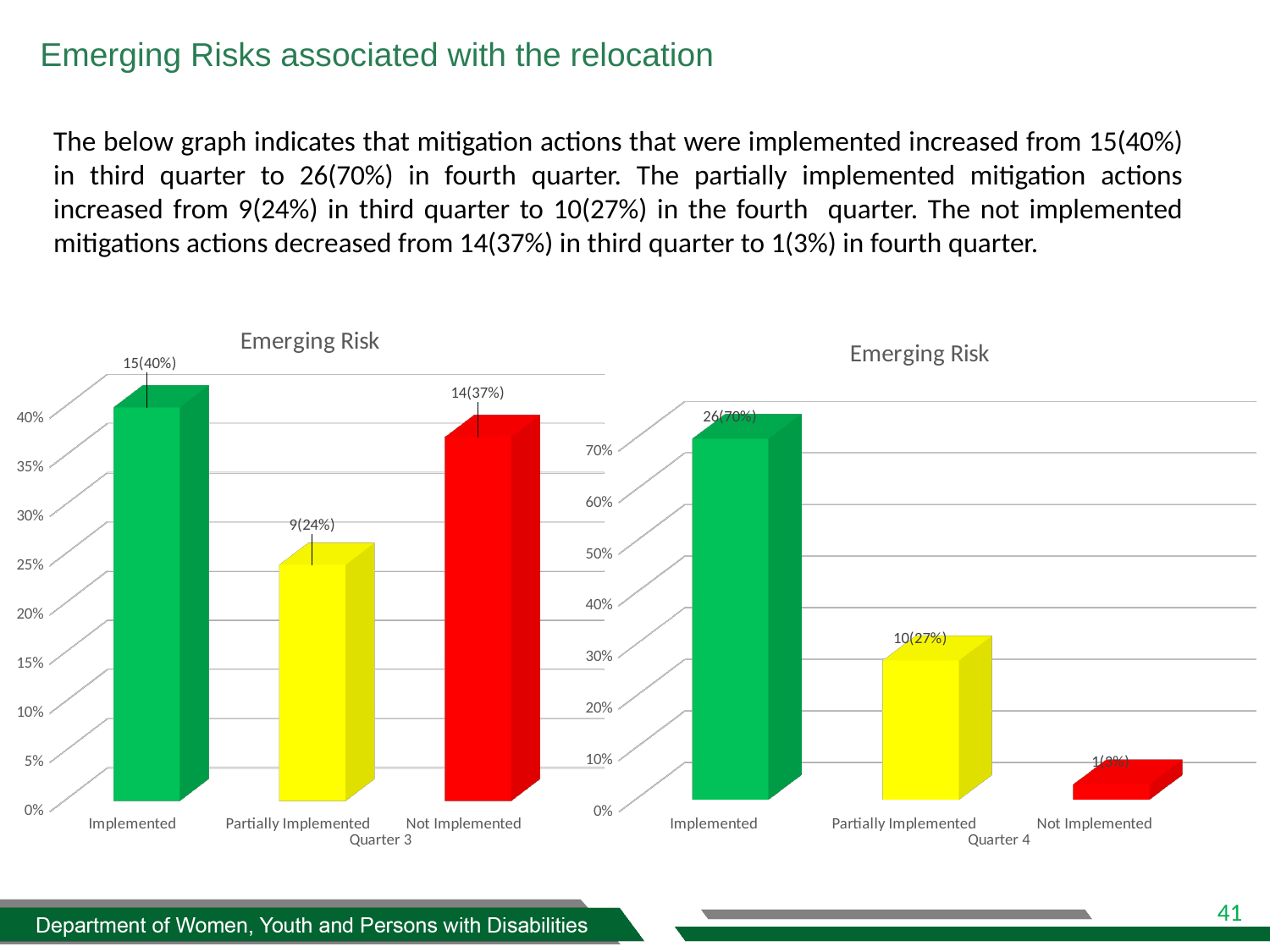
How many categories are shown in the left chart (Quarter 3)? 3 In the left chart (Quarter 3), which is larger: Implemented or Not Implemented? Implemented In the left chart (Quarter 3), which category has the lowest value? Partially Implemented In the left chart (Quarter 3), what is the data label for Partially Implemented? 9(24%) In the right chart (Quarter 4), what is the percentage-point difference between Implemented and Partially Implemented? 43% What is the title of the left chart? Emerging Risk In the left chart (Quarter 3), what is the data label for Implemented? 15(40%) In the right chart (Quarter 4), which category has the highest value? Implemented In the right chart (Quarter 4), which category has the lowest value? Not Implemented In the right chart (Quarter 4), what is the data label for Implemented? 26(70%) In the right chart (Quarter 4), what is the data label for Not Implemented? 1(3%) What type of chart is the right chart (Quarter 4)? Bar chart